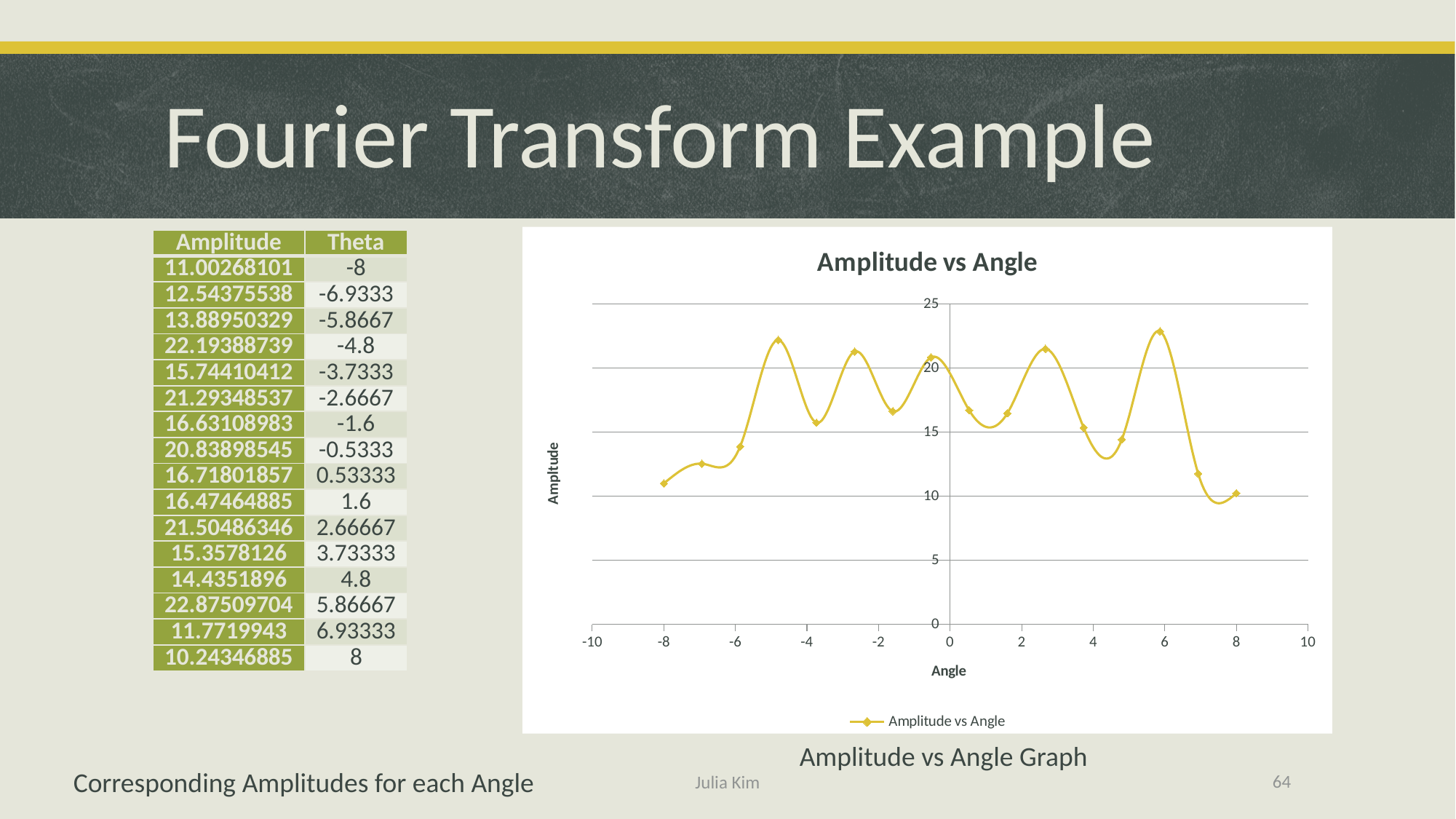
Is the amplitude at angle 2.66667 greater or less than 20? greater Which has the larger amplitude: angle -8 or angle 8? -8 At which angle does the amplitude reach its highest value? 5.86667 At which angle does the amplitude reach its lowest value? 8 What is the difference between the highest amplitude (at 5.86667) and the lowest amplitude (at 8)? 12.63162819 What is the title of the chart? Amplitude vs Angle What is the amplitude at angle 8? 10.24346885 Is the amplitude at angle -8 greater or less than 15? less How many series does the chart legend list? 1 What kind of chart is shown on the slide? line chart What is the amplitude at angle -4.8? 22.19388739 How many data points are plotted on the Amplitude vs Angle chart? 16